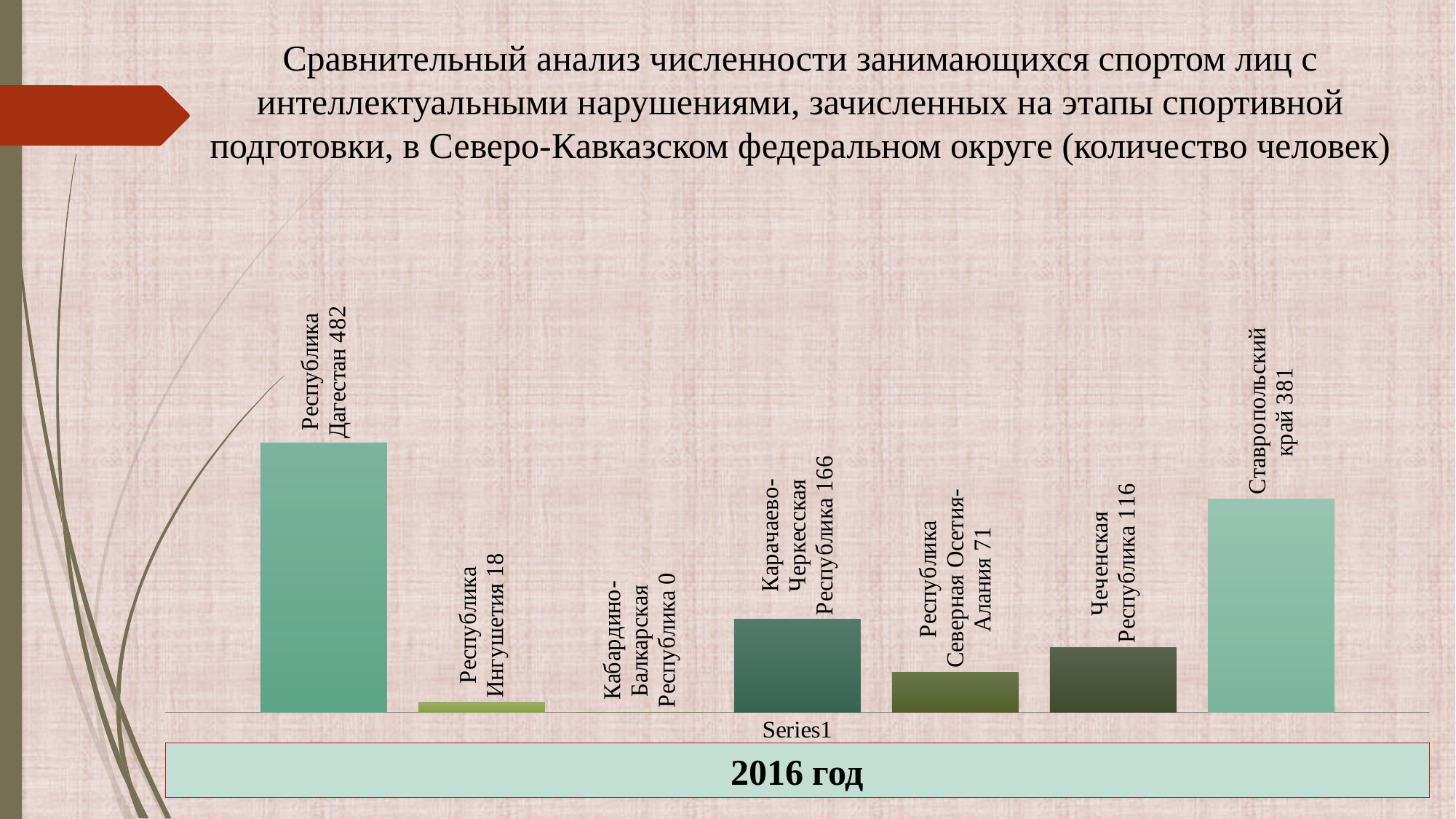
Which is larger, the value for Республика Северная Осетия-Алания or the value for Республика Ингушетия? Республика Северная Осетия-Алания What is the difference between the values for Республика Дагестан and Ставропольский край? 101 What is the value for Республика Дагестан? 482 What is the value for Ставропольский край? 381 How many regions are shown in the chart? 7 Which year does the chart refer to, according to the label below the chart? 2016 год Which region has the highest value? Республика Дагестан What is the value for Кабардино-Балкарская Республика? 0 What kind of chart is shown on the slide? bar chart What is the value for Чеченская Республика? 116 Which region has the lowest value? Кабардино-Балкарская Республика What is the difference between the values for Карачаево-Черкесская Республика and Чеченская Республика? 50